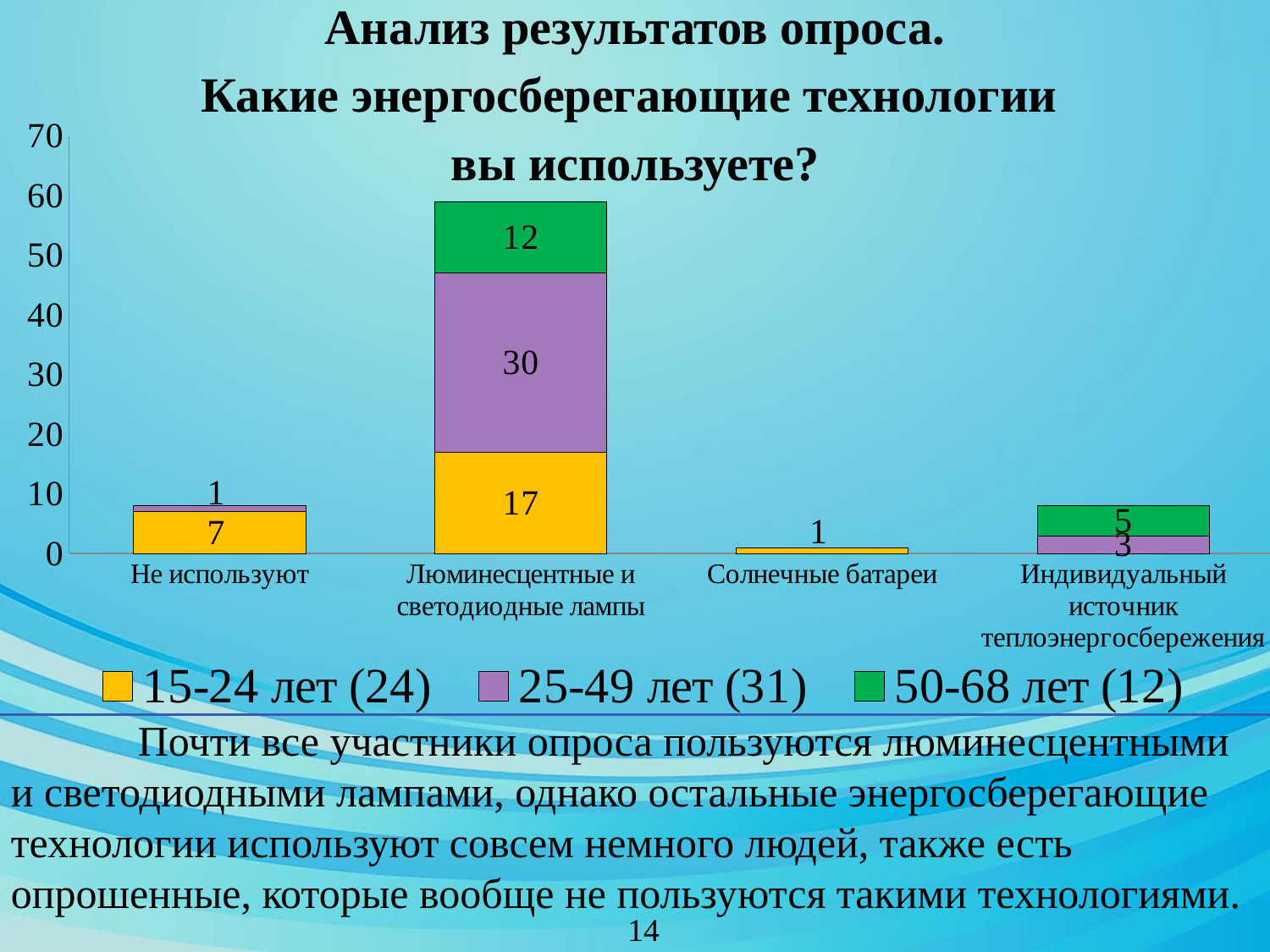
Which category has the highest total bar? Люминесцентные и светодиодные лампы What is the value for the 25-49 лет series in the 'Люминесцентные и светодиодные лампы' category? 30 What kind of chart is shown on the slide? stacked bar chart What is the value for the 15-24 лет series in the 'Люминесцентные и светодиодные лампы' category? 17 What is the total of the stacked bar for 'Люминесцентные и светодиодные лампы'? 59 What is the value for the 50-68 лет series in the 'Индивидуальный источник теплоэнергосбережения' category? 5 Which category has the lowest total bar? Солнечные батареи How many series does the legend list? 3 What is the value for the 15-24 лет series in the 'Не используют' category? 7 How many categories are shown on the x axis of the chart? 4 What is the total of the stacked bar for 'Не используют'? 8 What is the difference between the 25-49 лет value and the 50-68 лет value in the 'Люминесцентные и светодиодные лампы' category? 18